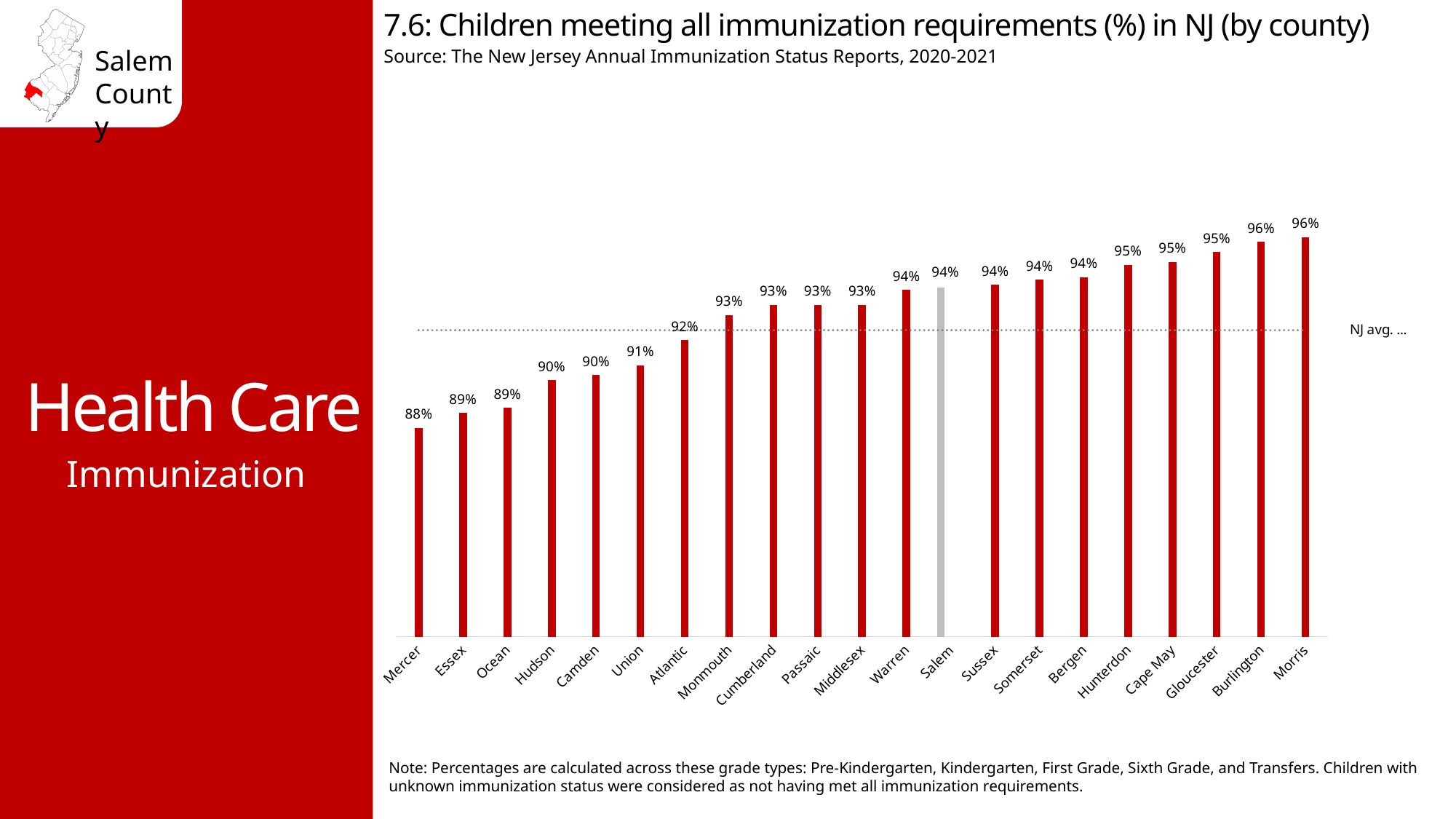
Which county has the lowest percentage of children meeting all immunization requirements? Mercer What is the difference in percentage points between Morris County and Mercer County? 8 percentage points What is the difference in percentage points between Salem County and Mercer County? 6 percentage points What type of chart is used on this slide? Bar chart How many counties are shown on the chart? 21 Which county's bar is shown in grey instead of red? Salem What percentage of children in Salem County met all immunization requirements? 94% Which two counties share the highest value on the chart? Burlington and Morris What is the value shown for Mercer County? 88% What is the value shown for Hunterdon County? 95% What is the value shown for Atlantic County? 92% Which has a higher value, Hudson County or Atlantic County? Atlantic